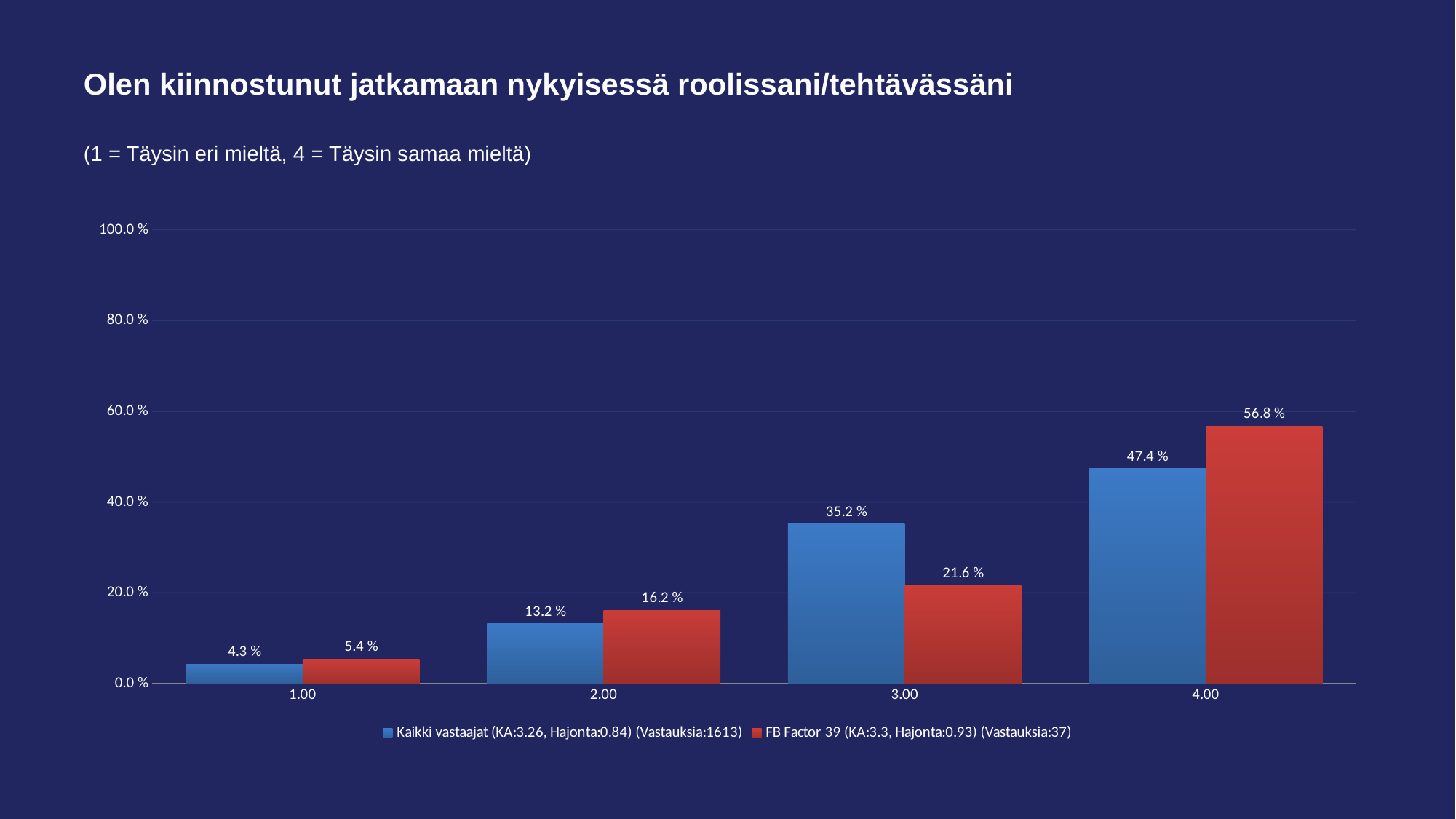
What is the value for FB Factor 39 at 3.00? 21.6 % What kind of chart is shown on the slide? bar chart What is the difference between FB Factor 39 and Kaikki vastaajat at 3.00? 13.6 % Which category has the highest value for FB Factor 39? 4.00 How many categories are shown on the x axis? 4 What is the value for FB Factor 39 at 2.00? 16.2 % Is the value for Kaikki vastaajat at 3.00 greater or less than 40.0 %? less How many series does the legend list? 2 At 4.00, which series has the larger value, Kaikki vastaajat or FB Factor 39? FB Factor 39 Which category has the lowest value for Kaikki vastaajat? 1.00 What is the value for Kaikki vastaajat at 1.00? 4.3 % What is the value for Kaikki vastaajat at 4.00? 47.4 %